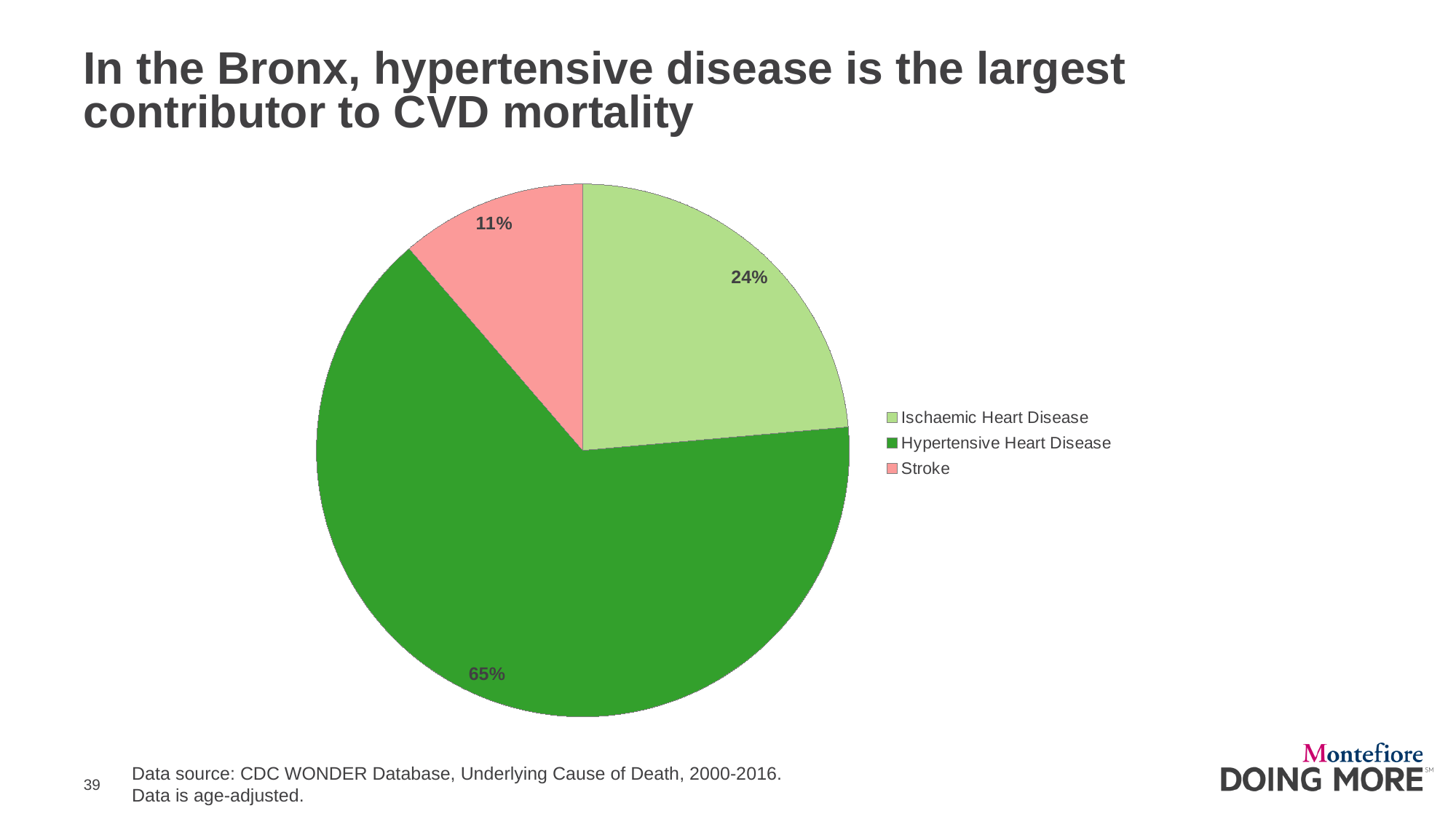
What share of the pie does Stroke account for? 11% What share of the pie does Hypertensive Heart Disease account for? 65% Which category has the smallest slice of the pie? Stroke What share of the pie does Ischaemic Heart Disease account for? 24% What is the data source cited at the bottom of the slide? CDC WONDER Database, Underlying Cause of Death, 2000-2016 How many categories are shown in the pie chart? 3 What is the difference in percentage points between Hypertensive Heart Disease and Ischaemic Heart Disease? 41 percentage points What is the difference in percentage points between Ischaemic Heart Disease and Stroke? 13 percentage points What kind of chart is shown on the slide? Pie chart Which category has the largest slice of the pie? Hypertensive Heart Disease Which is larger, the share for Ischaemic Heart Disease or the share for Stroke? Ischaemic Heart Disease What colour is the Stroke slice in the pie chart? Pink